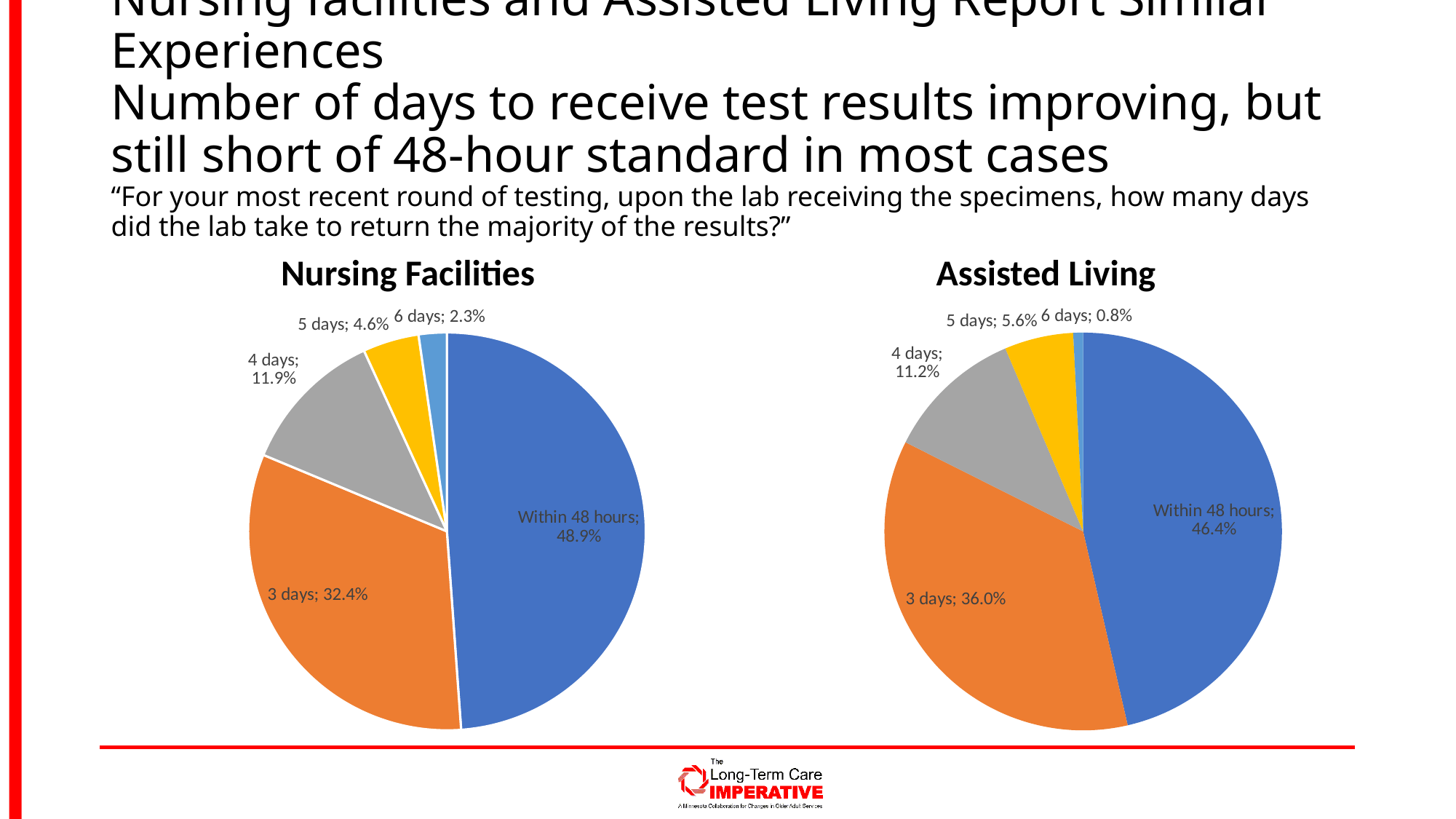
In the Assisted Living pie chart, what is the combined share of 4 days, 5 days and 6 days? 17.6% In the Assisted Living pie chart, which category has the smallest share? 6 days How many categories are shown in the Assisted Living pie chart? 5 What type of chart is used for Nursing Facilities? Pie chart In the Nursing Facilities pie chart, which category has the largest share? Within 48 hours In the Assisted Living pie chart, what share of respondents received results in 3 days? 36.0% Which chart shows a larger share for 5 days, Nursing Facilities or Assisted Living? Assisted Living In the Nursing Facilities pie chart, what share of respondents received results within 48 hours? 48.9% In the Nursing Facilities pie chart, what is the difference between the Within 48 hours share and the 3 days share? 16.5% What colour is the 3 days slice in both pie charts? Orange In the Assisted Living pie chart, what is the value for 6 days? 0.8% In the Nursing Facilities pie chart, what is the value for 4 days? 11.9%